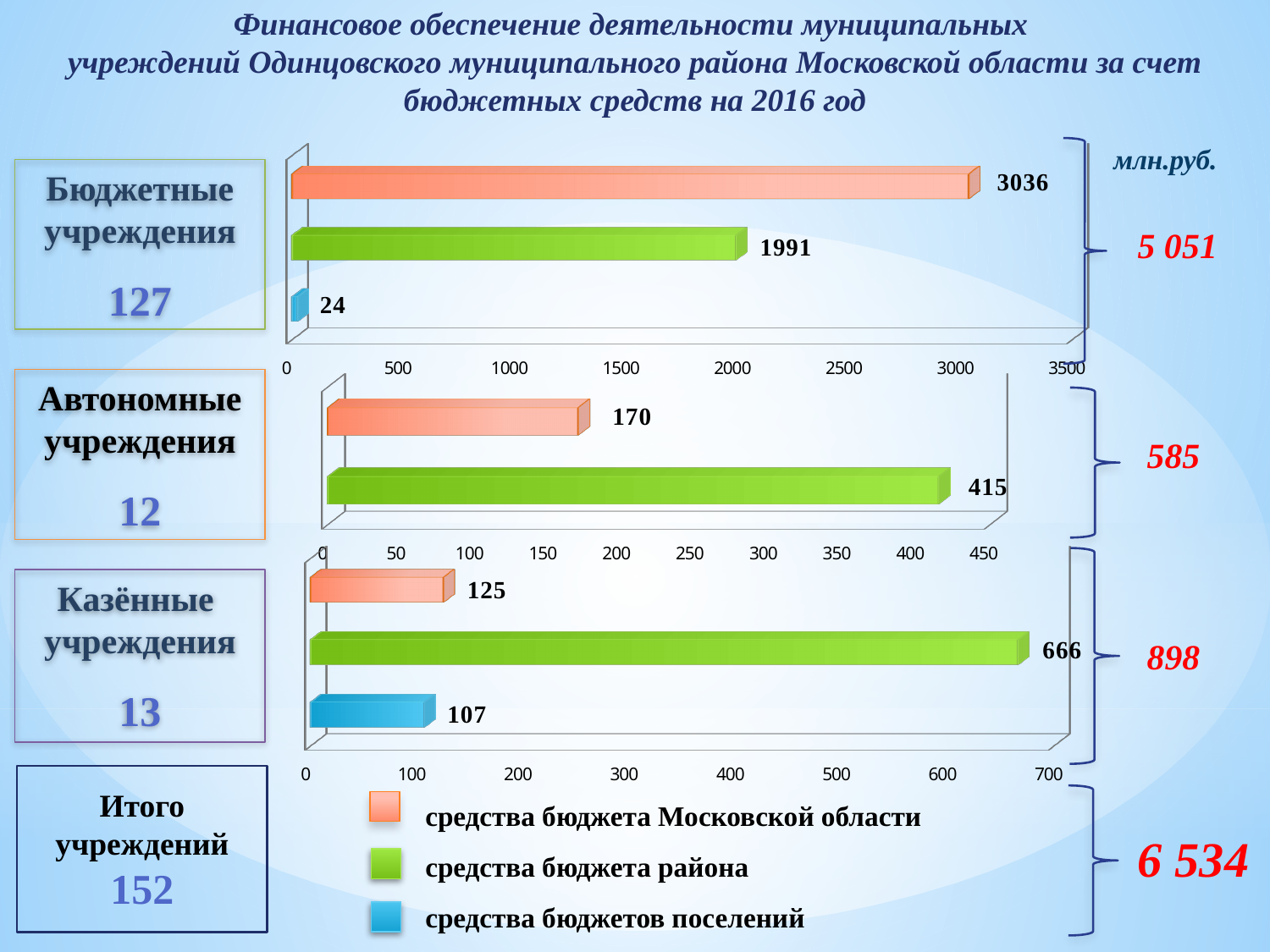
In the Автономные учреждения chart, what is the value for средства бюджета района? 415 What type of chart is used for Казённые учреждения? bar chart How many budget sources does the legend at the bottom of the slide list? 3 In the Казённые учреждения chart, which source has the highest value? средства бюджета района How many bars are plotted in the Автономные учреждения chart? 2 In the Автономные учреждения chart, which is larger: средства бюджета Московской области or средства бюджета района? средства бюджета района In the Бюджетные учреждения chart, what is the value for средства бюджета Московской области? 3036 In the Бюджетные учреждения chart, what is the difference between средства бюджета Московской области and средства бюджета района? 1045 In the Бюджетные учреждения chart, what is the value for средства бюджетов поселений? 24 In the Казённые учреждения chart, what is the value for средства бюджета Московской области? 125 In the Бюджетные учреждения chart, which source has the lowest value? средства бюджетов поселений In the Казённые учреждения chart, what is the difference between средства бюджета района and средства бюджетов поселений? 559